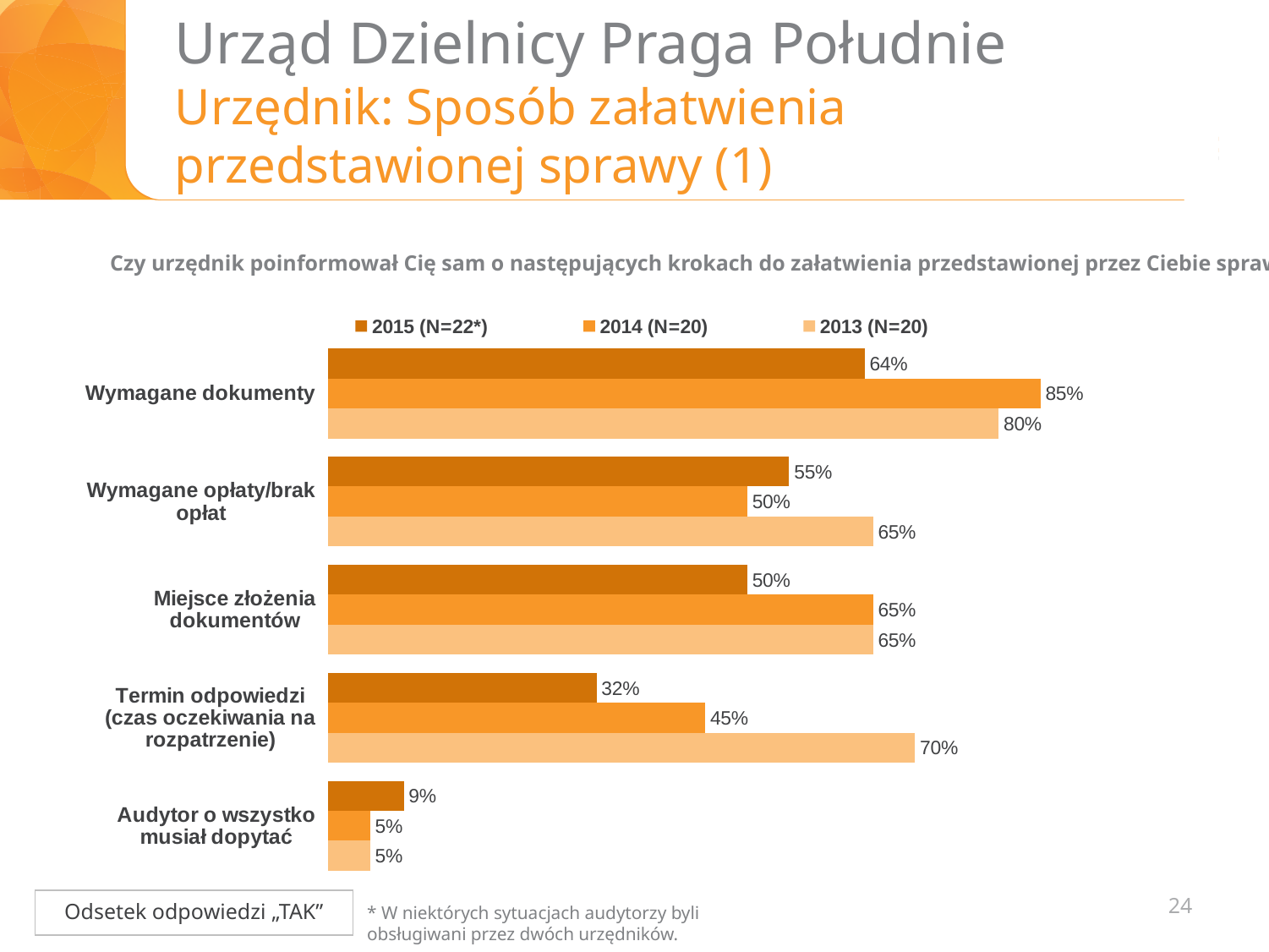
How many categories are shown on the chart? 5 What are the three series listed in the legend? 2015 (N=22*), 2014 (N=20), 2013 (N=20) What kind of chart is shown on the slide? Bar chart For 'Termin odpowiedzi (czas oczekiwania na rozpatrzenie)', which series has the larger value: 2015 (N=22*) or 2014 (N=20)? 2014 (N=20) What is the value for 'Miejsce złożenia dokumentów' in the 2013 (N=20) series? 65% What is the value for 'Termin odpowiedzi (czas oczekiwania na rozpatrzenie)' in the 2013 (N=20) series? 70% What is the difference between the 2014 and 2015 values for 'Wymagane dokumenty'? 21 percentage points Which category has the lowest value in the 2015 (N=22*) series? Audytor o wszystko musiał dopytać How many series does the legend list? 3 What is the value for 'Wymagane dokumenty' in the 2015 (N=22*) series? 64% Which category has the highest value in the 2014 (N=20) series? Wymagane dokumenty What is the value for 'Audytor o wszystko musiał dopytać' in the 2014 (N=20) series? 5%